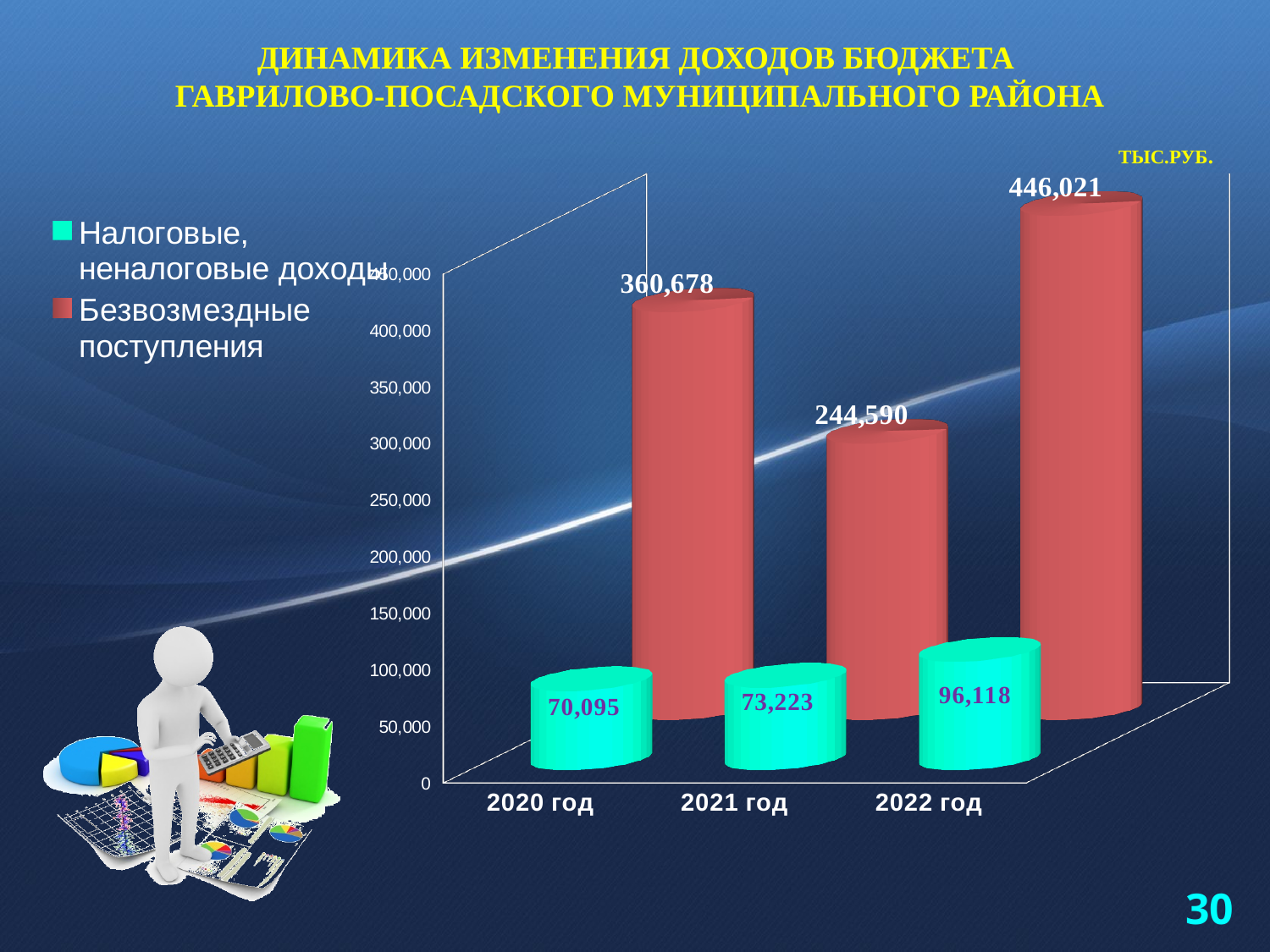
How many years are shown on the x axis? 3 What is the difference between Безвозмездные поступления in 2022 год and 2021 год? 201,431 What is the value of Налоговые, неналоговые доходы for 2022 год? 96,118 In which year is Налоговые, неналоговые доходы lowest? 2020 год What is the difference between Налоговые, неналоговые доходы in 2022 год and 2020 год? 26,023 Which is larger: Безвозмездные поступления in 2020 год or in 2021 год? 2020 год In which year is Безвозмездные поступления highest? 2022 год What kind of chart is shown on the slide? Bar chart How many series does the legend list? 2 Is the value of Безвозмездные поступления for 2022 год greater or less than 400,000? greater What is the value of Безвозмездные поступления for 2021 год? 244,590 What is the value of Налоговые, неналоговые доходы for 2020 год? 70,095